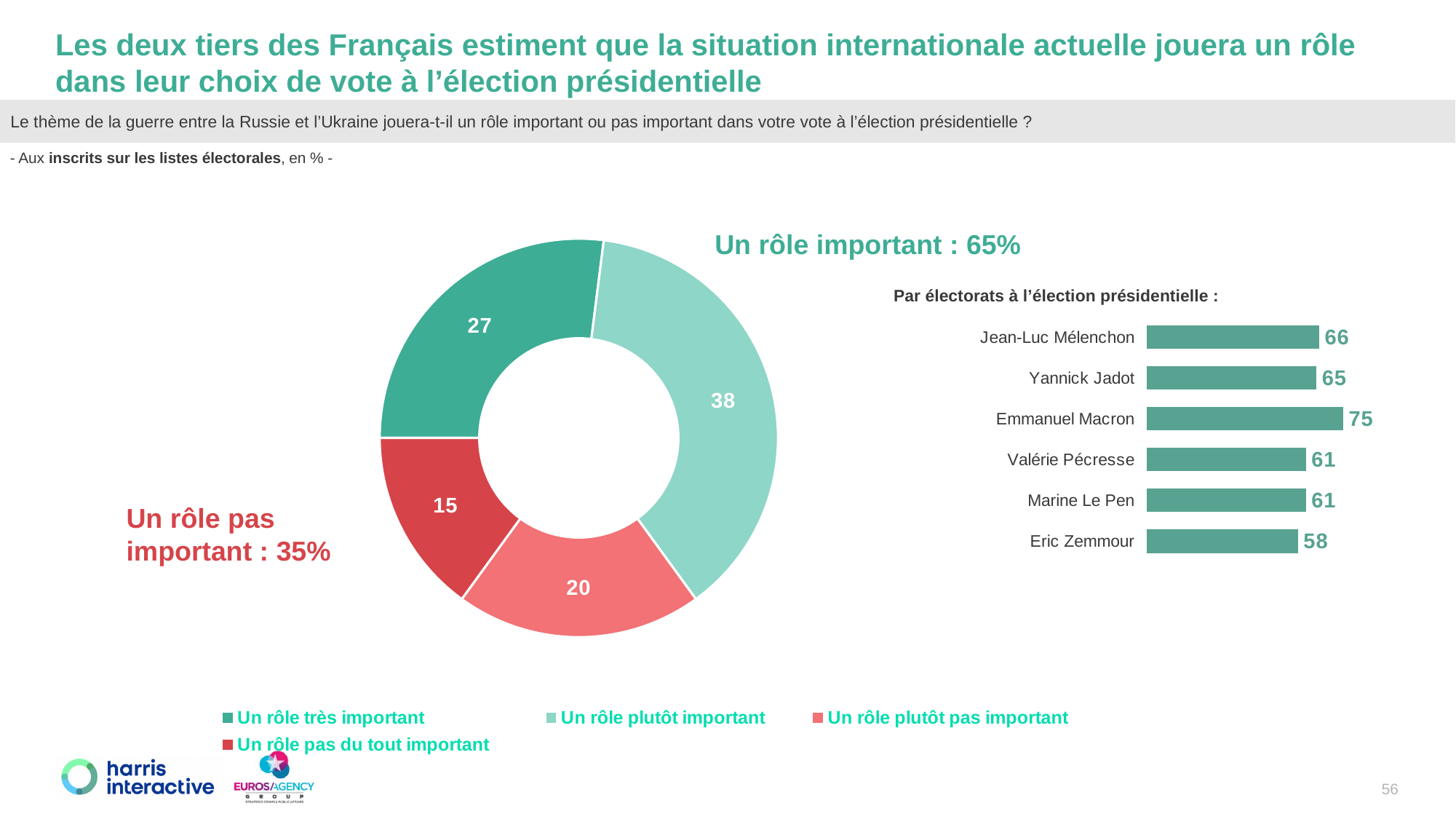
In the bar chart 'Par électorats à l'élection présidentielle', which is larger: Jean-Luc Mélenchon or Yannick Jadot? Jean-Luc Mélenchon What kind of chart is the chart on the left of the slide? Donut chart In the bar chart 'Par électorats à l'élection présidentielle', what is the difference between Emmanuel Macron and Eric Zemmour? 17 In the donut chart on the left, which category has the largest share? Un rôle plutôt important In the bar chart 'Par électorats à l'élection présidentielle', which electorate has the lowest value? Eric Zemmour In the donut chart on the left, what is the value for 'Un rôle pas du tout important'? 15 In the donut chart on the left, what is the value for 'Un rôle plutôt important'? 38 In the bar chart 'Par électorats à l'élection présidentielle', what is the value for Emmanuel Macron? 75 In the donut chart on the left, what is the difference between 'Un rôle très important' and 'Un rôle plutôt pas important'? 7 How many electorates are shown in the bar chart 'Par électorats à l'élection présidentielle'? 6 In the donut chart on the left, which category has the smallest share? Un rôle pas du tout important How many categories does the legend of the donut chart list? 4